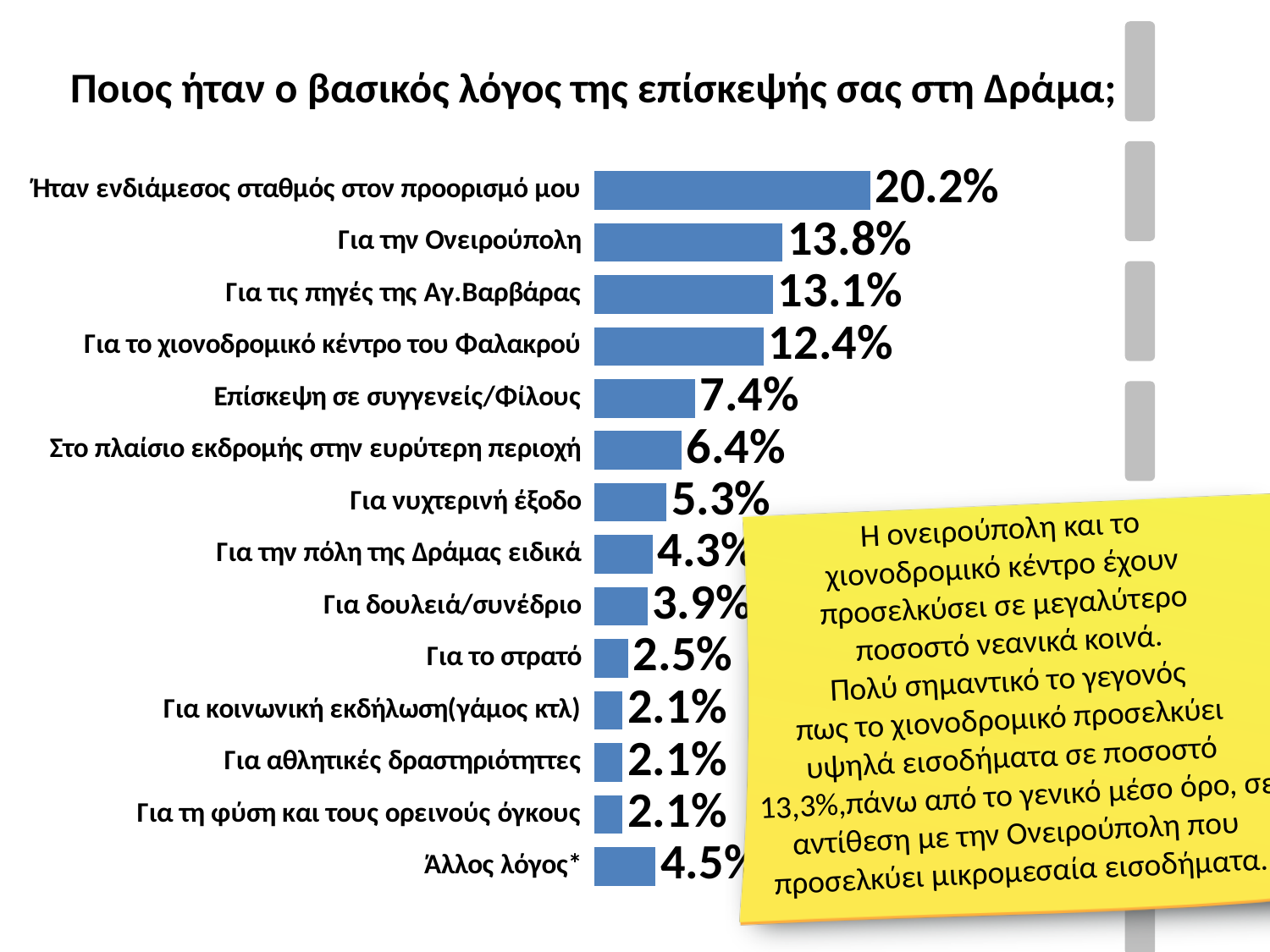
What is the value for 'Για το χιονοδρομικό κέντρο του Φαλακρού'? 12.4% What is the value for 'Επίσκεψη σε συγγενείς/Φίλους'? 7.4% How many categories are shown in the chart? 14 Which is larger, the value for 'Για τις πηγές της Αγ.Βαρβάρας' or for 'Για το χιονοδρομικό κέντρο του Φαλακρού'? Για τις πηγές της Αγ.Βαρβάρας What is the difference between the values for 'Ήταν ενδιάμεσος σταθμός στον προορισμό μου' and 'Για την Ονειρούπολη'? 6.4% What is the title of the chart? Ποιος ήταν ο βασικός λόγος της επίσκεψής σας στη Δράμα; What is the value for 'Για το στρατό'? 2.5% What is the value for 'Για την Ονειρούπολη'? 13.8% What is the value for 'Ήταν ενδιάμεσος σταθμός στον προορισμό μου'? 20.2% What is the lowest value shown in the chart? 2.1% Which category has the highest value? Ήταν ενδιάμεσος σταθμός στον προορισμό μου What kind of chart is shown on the slide? bar chart